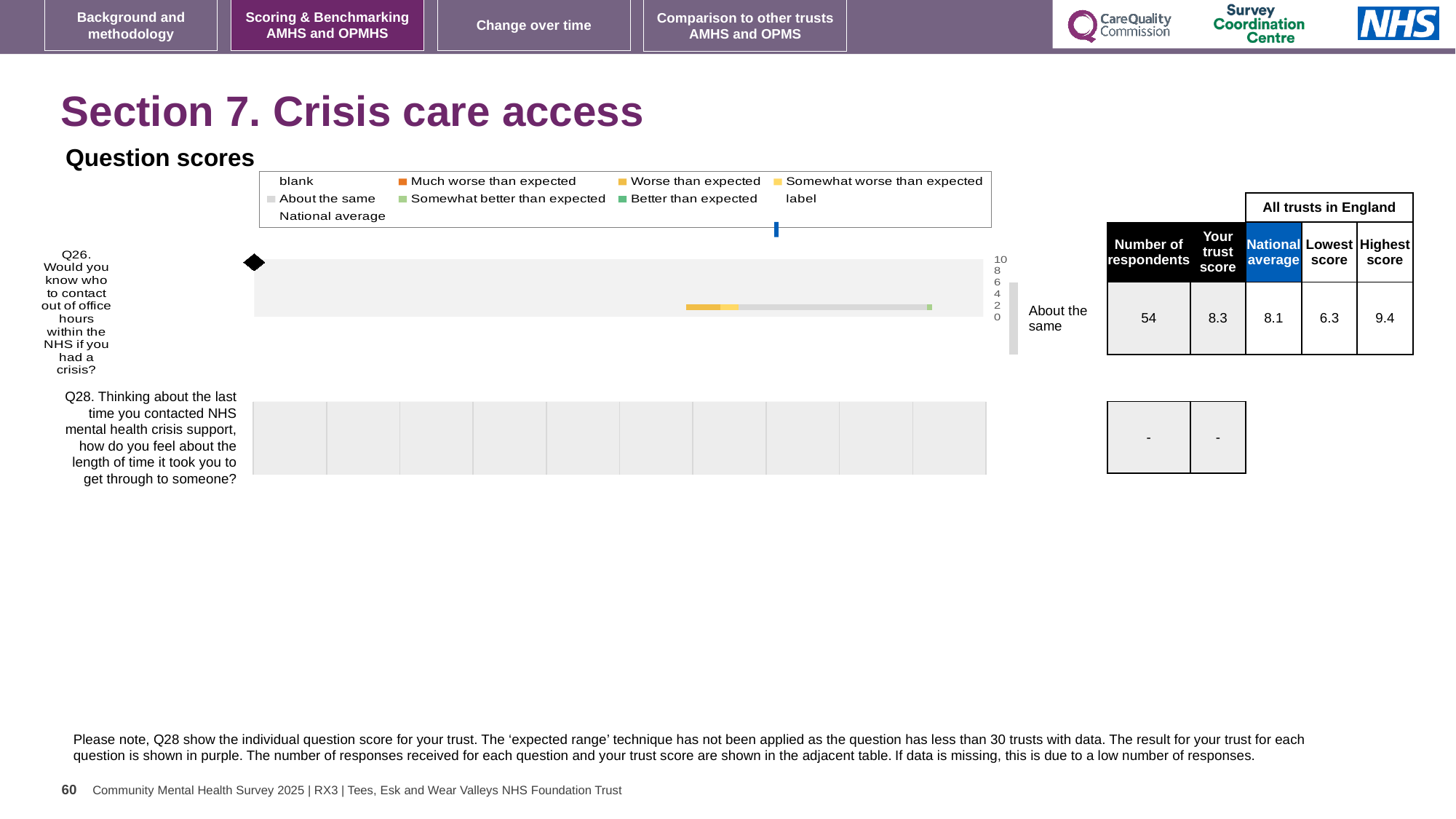
What is the highest score among all trusts in England for Q26? 9.4 By how much does the trust score for Q26 exceed the national average? 0.2 What is the national average score for Q26? 8.1 How is the trust's result for Q26 categorised relative to the expected range? About the same How many respondents answered Q26? 54 What is shown as the trust score for Q28 in the table? - How many questions are plotted in the Question scores chart? 2 What is the difference between the highest and lowest scores for Q26 across all trusts in England? 3.1 What is the lowest score among all trusts in England for Q26? 6.3 What kind of chart is used to show the question scores? bar chart What is the trust score for Q26 (Would you know who to contact out of office hours within the NHS if you had a crisis?)? 8.3 For Q26, which is larger: the trust score or the national average? the trust score